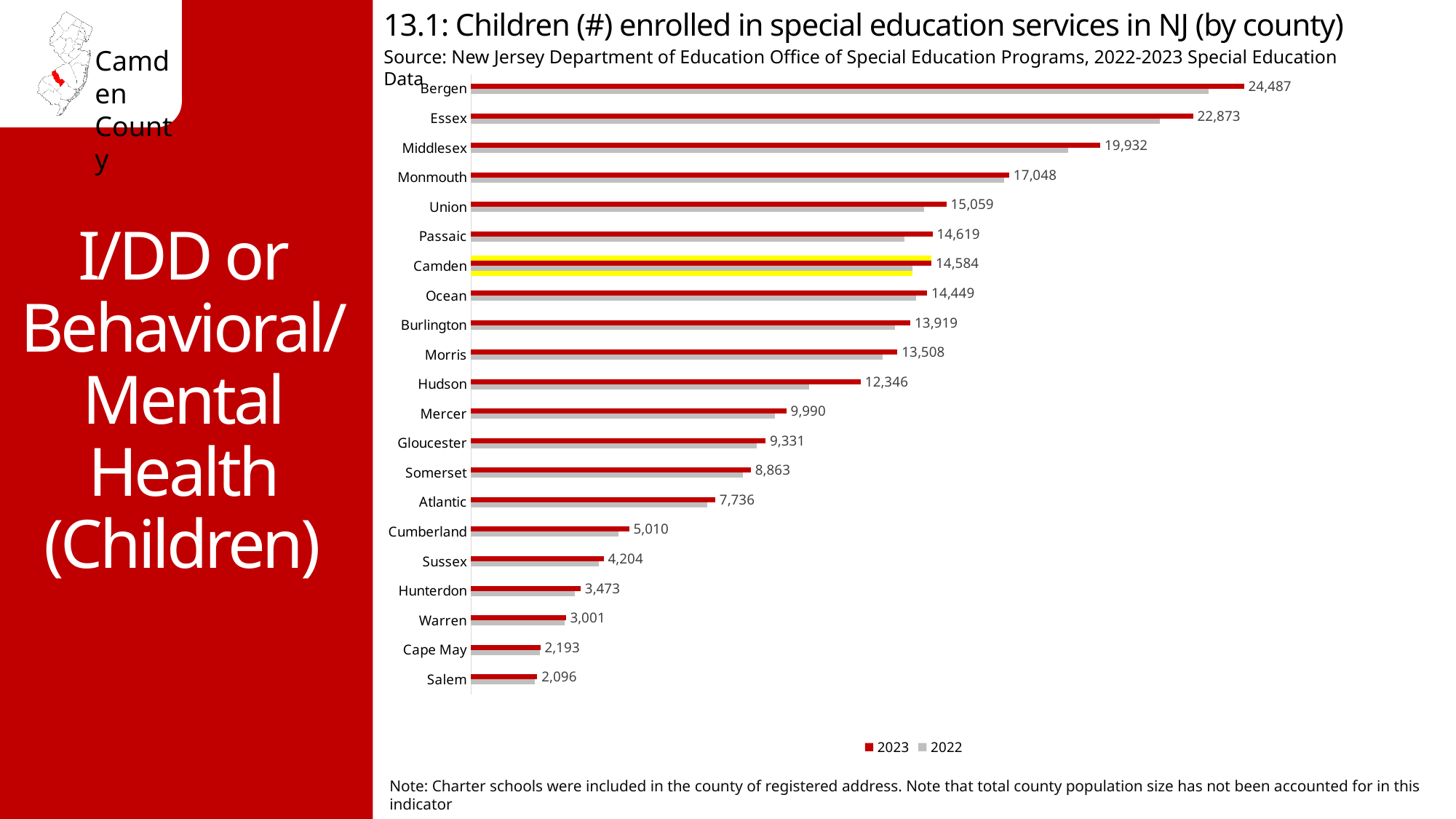
What is the difference between the 2023 values for Hudson and Mercer? 2,356 What is the 2023 value for Cumberland? 5,010 Which county has the highest 2023 value? Bergen What type of chart is shown on the slide? bar chart How many series does the legend list? 2 How many counties are shown on the chart? 21 What is the 2023 value for Bergen? 24,487 What is the difference between the 2023 values for Bergen and Essex? 1,614 Which series is shown in red in the legend? 2023 Which county has the lowest 2023 value? Salem What is the 2023 value for Camden? 14,584 Which has the larger 2023 value, Gloucester or Somerset? Gloucester